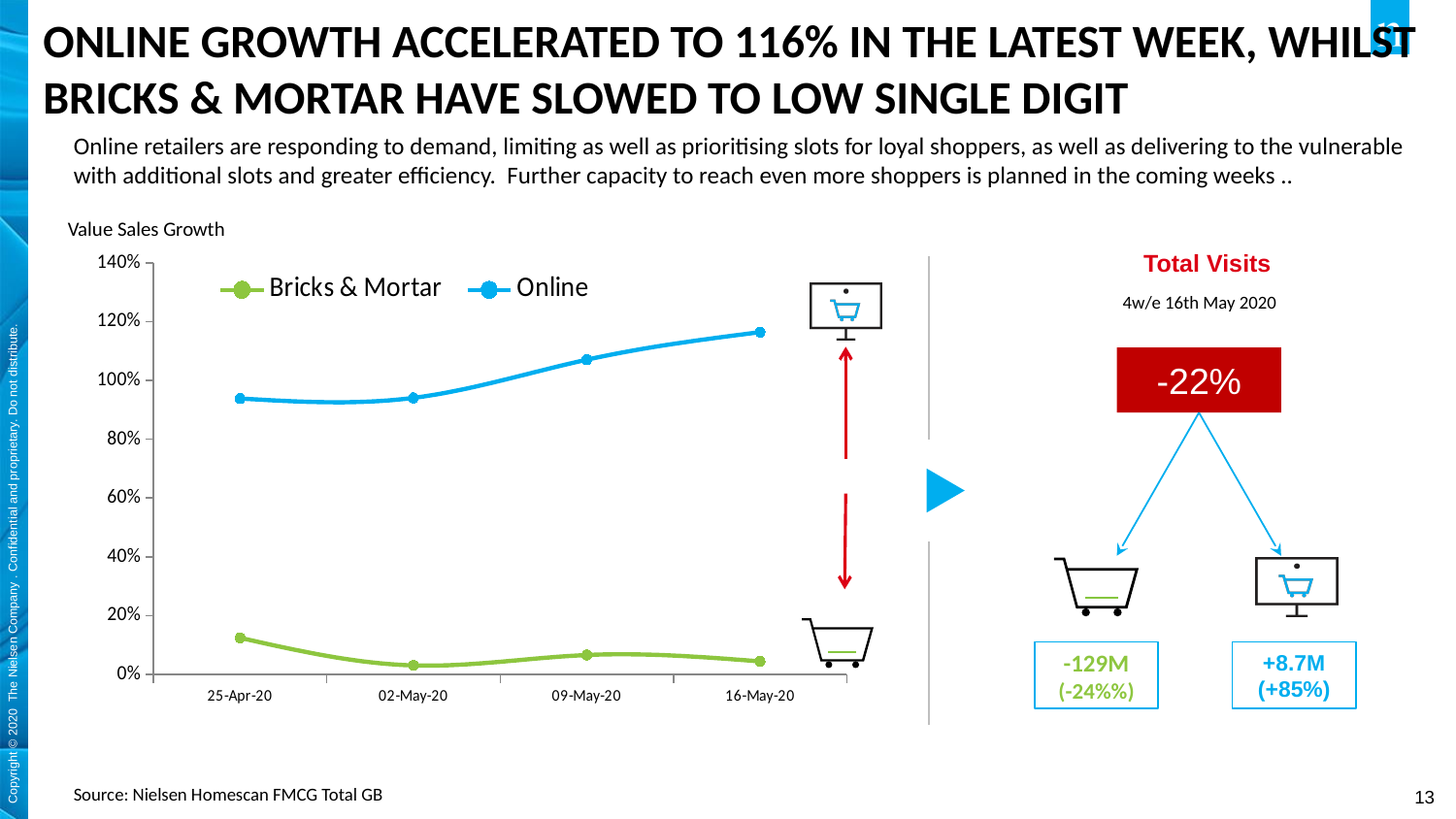
Which series is higher at 16-May-20, Bricks & Mortar or Online? Online How many dates are plotted along the x axis of the chart? 4 Is the Online value at 16-May-20 greater or less than 100%? greater Does the Online series rise or fall from 02-May-20 to 16-May-20? rise What are the two series named in the chart legend? Bricks & Mortar and Online On which date does the Online series reach its highest value? 16-May-20 Is the Bricks & Mortar value at 02-May-20 greater or less than 20%? less What is the axis title shown above the chart? Value Sales Growth Is the Online value at 25-Apr-20 greater or less than 100%? less How many series does the chart legend list? 2 On which date does the Bricks & Mortar series reach its highest value? 25-Apr-20 What kind of chart is shown on the slide? line chart